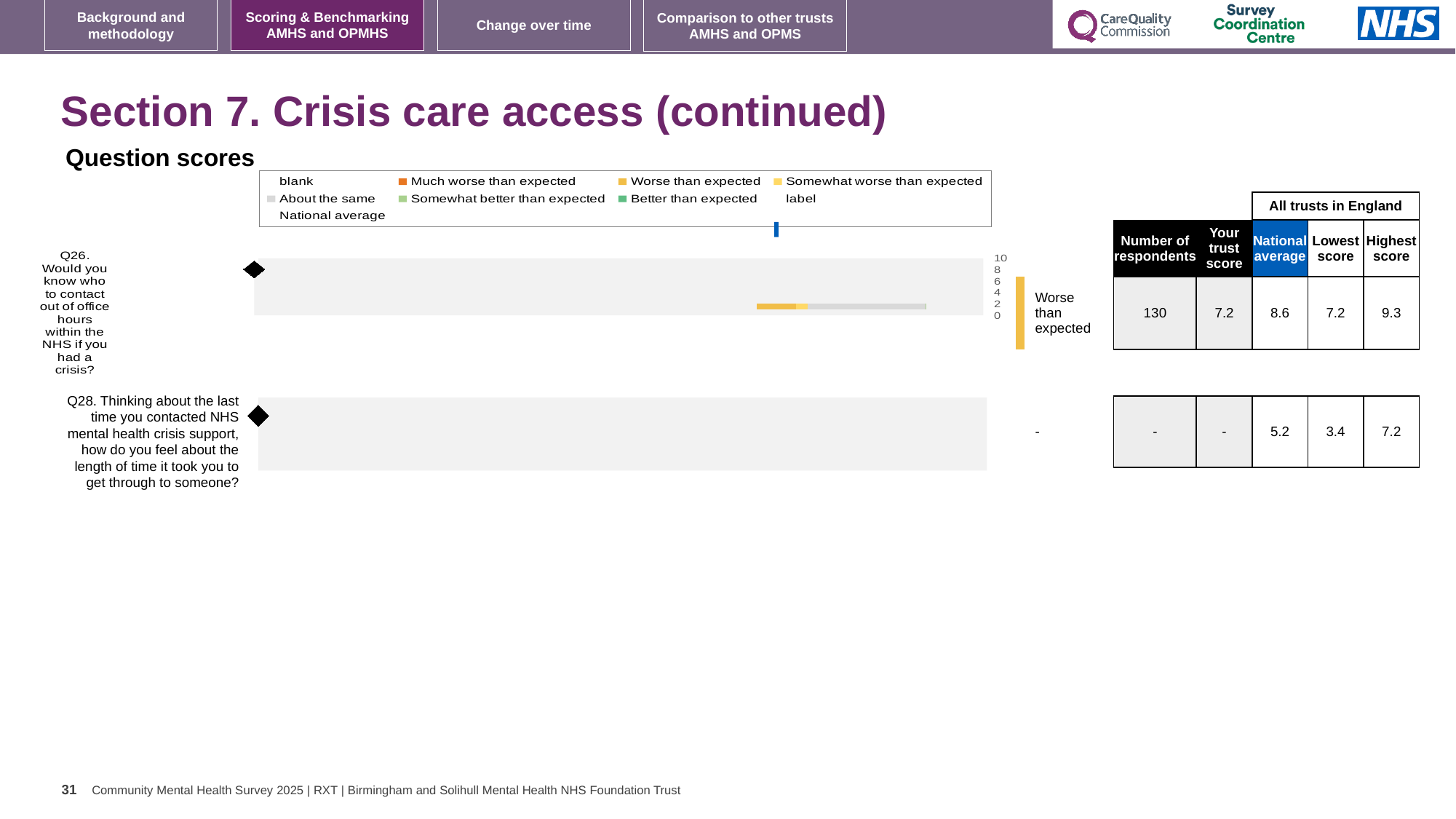
How many entries does the legend of the question scores chart list? 9 In the table beside the chart, what is the difference between the national average and the trust's score for Q26? 1.4 How many questions (categories) are plotted in the question scores chart? 2 What is the highest value shown on the score axis of the question scores chart? 10 Which legend entry in the question scores chart is shown in orange? Much worse than expected In the table beside the chart, which is larger for Q26: the national average or the trust's score? national average In the table beside the chart, what is the trust's score for Q26? 7.2 In the table beside the chart, what is the number of respondents for Q26? 130 What benchmark category is shown next to the Q26 bar in the question scores chart? Worse than expected In the table beside the chart, what is the national average for Q26? 8.6 What kind of chart is used for the question scores on this slide? bar chart In the table beside the chart, what is the highest score across all trusts in England for Q28? 7.2